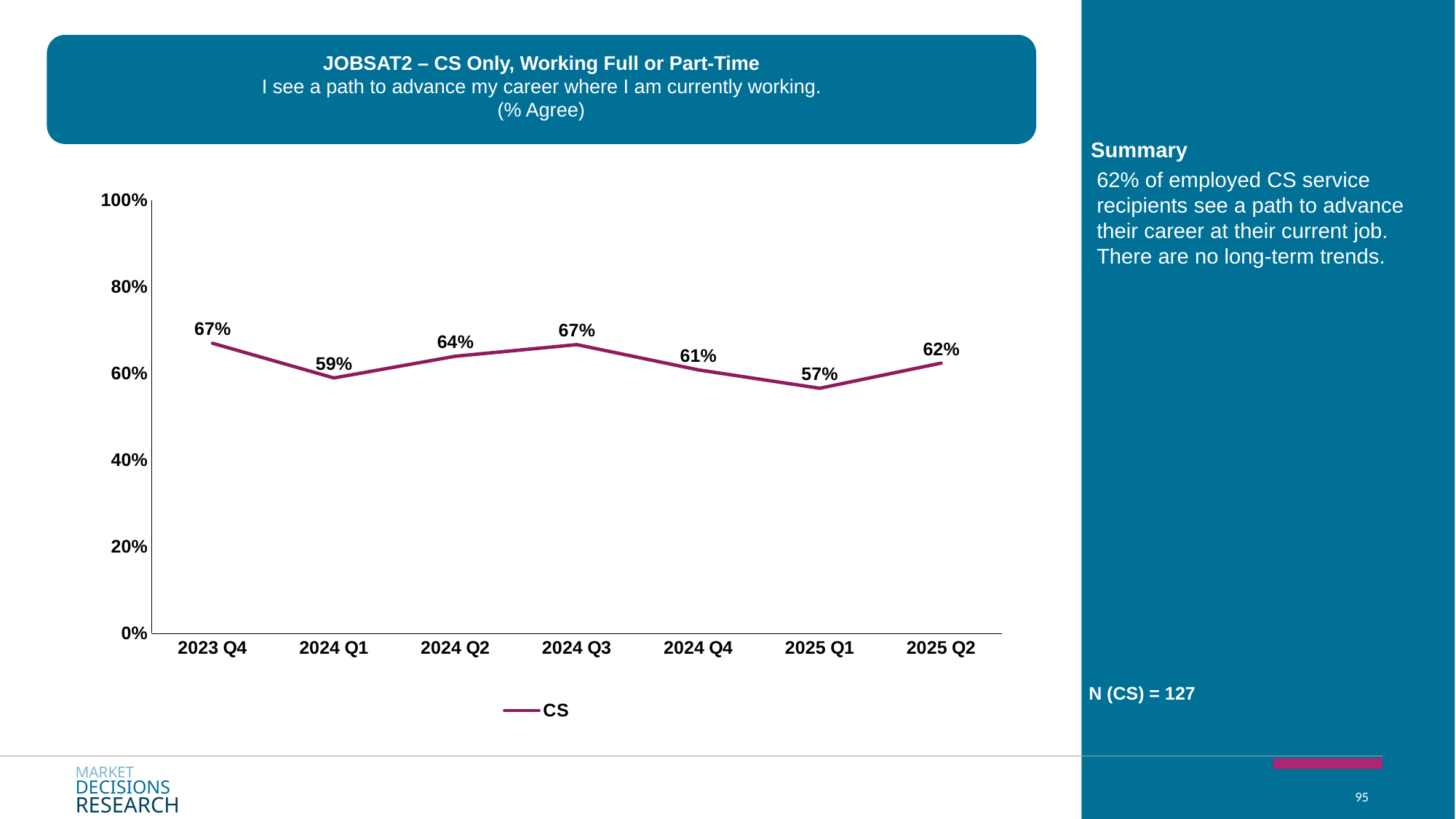
How many quarters are plotted on the x axis? 7 What is the value for 2024 Q3? 67% What is the value for 2024 Q1? 59% Does the value rise or fall from 2025 Q1 to 2025 Q2? rise What is the difference between the values for 2024 Q3 and 2025 Q1? 10% What kind of chart is shown? line chart What series name is shown in the legend? CS Which quarter has the lowest value? 2025 Q1 Which is larger, the value for 2024 Q2 or the value for 2024 Q4? 2024 Q2 Is the value for 2024 Q1 greater or less than 60%? less How many series does the legend list? 1 What is the value for 2025 Q2? 62%